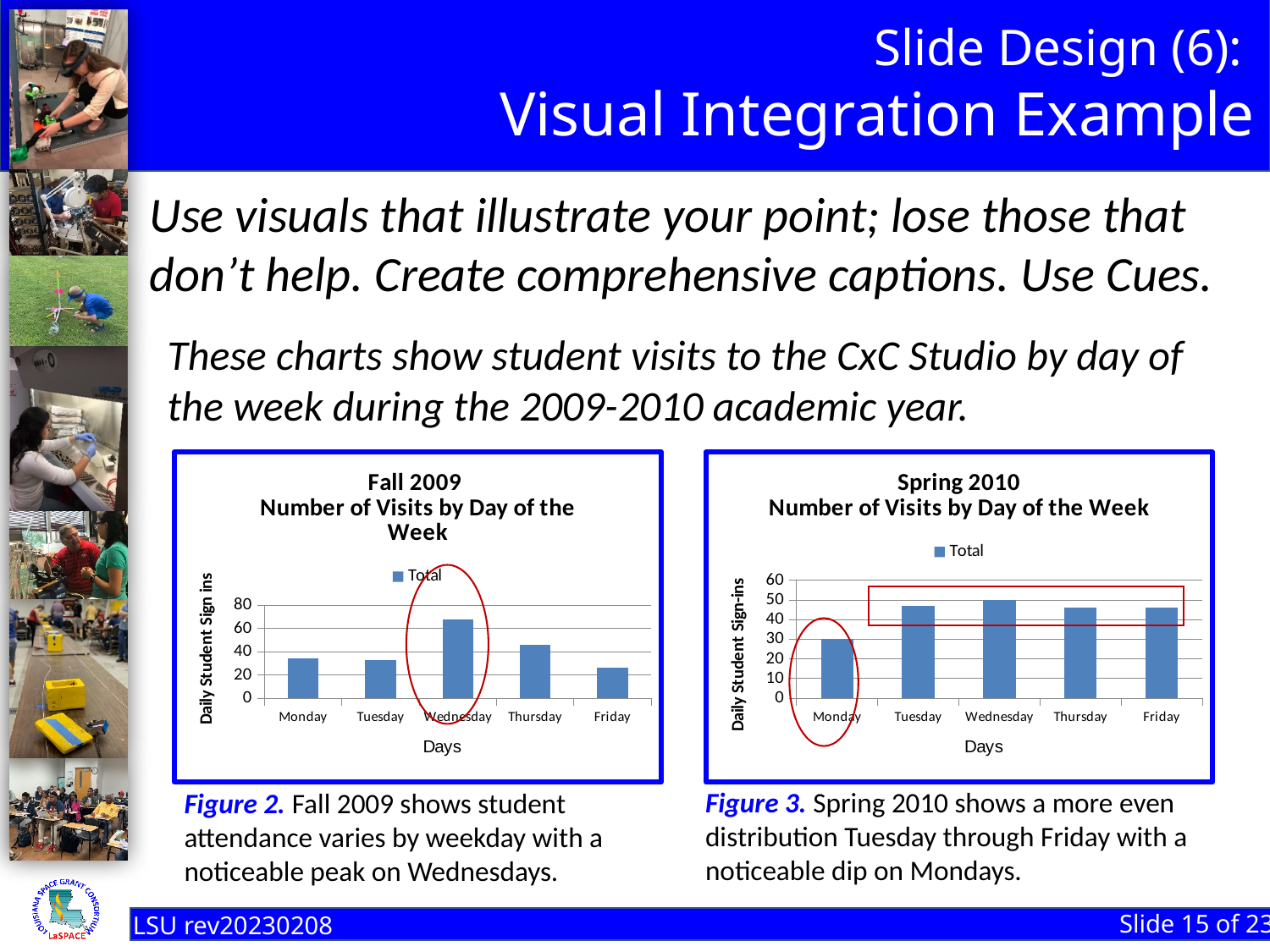
What kind of chart is the Fall 2009 chart? bar chart In the Fall 2009 chart, which is larger, the value for Wednesday or the value for Thursday? Wednesday In the Fall 2009 chart, is the value for Wednesday greater or less than 60? greater In the Spring 2010 chart, is the value for Monday greater or less than 40? less In the Fall 2009 chart, which day has the lowest number of visits? Friday In the Fall 2009 chart, which day has the highest number of visits? Wednesday In the Fall 2009 chart, is the value for Friday greater or less than 40? less How many days are shown on the x axis of the Spring 2010 chart? 5 In the Spring 2010 chart, which day has the lowest number of visits? Monday What is the y-axis label of the Spring 2010 chart? Daily Student Sign-ins How many series does the legend of the Fall 2009 chart list? 1